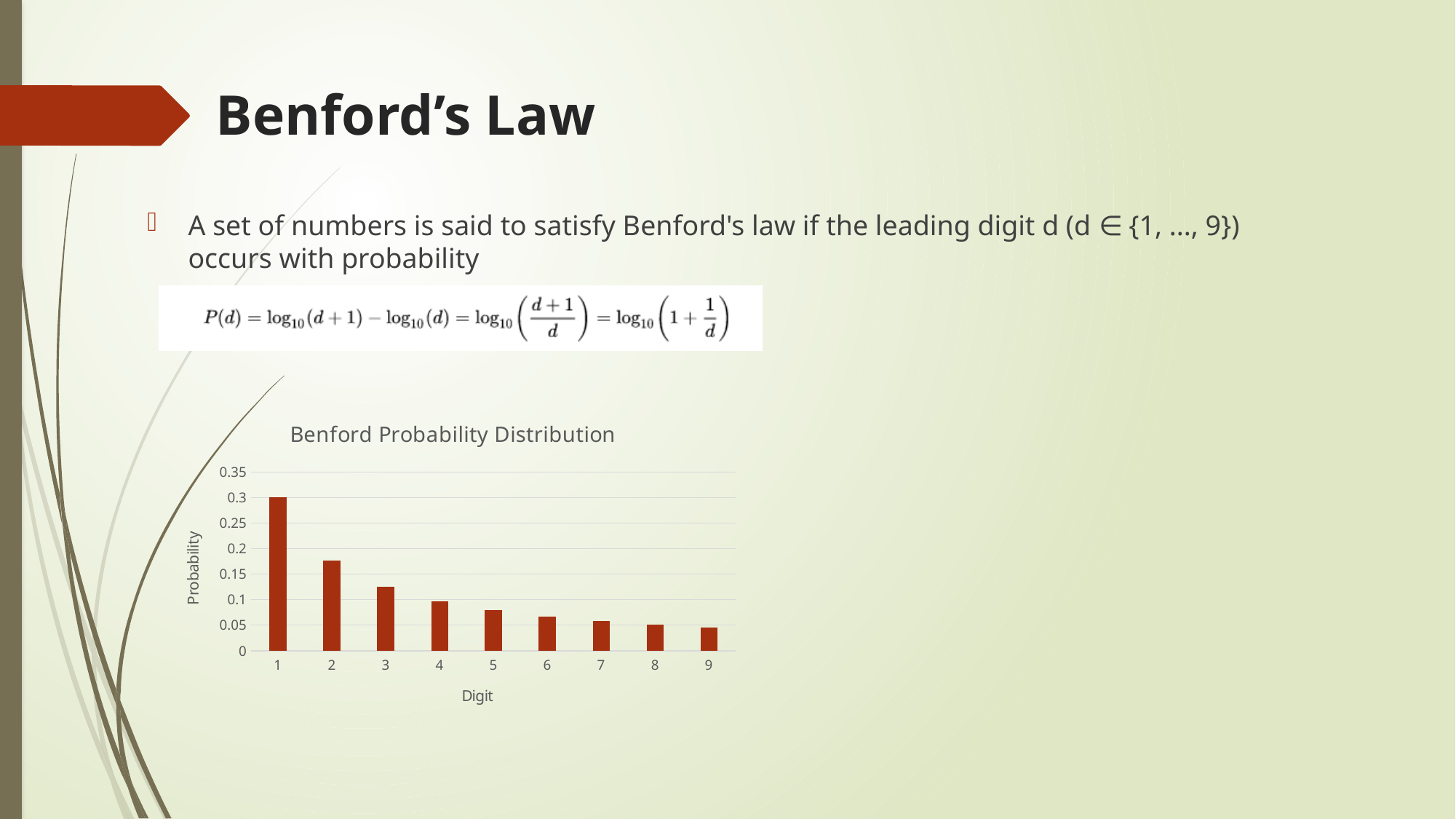
What is the label on the y axis of the chart? Probability What is the title of the chart? Benford Probability Distribution Which digit has the lowest probability in the chart? 9 How many digits (categories) are plotted on the x axis of the chart? 9 Is the probability for digit 2 greater or less than 0.2? less Is the probability for digit 5 greater or less than 0.1? less Is the probability for digit 1 greater or less than 0.25? greater Which digit has the highest probability in the chart? 1 Do the probabilities rise or fall as the digit increases from 1 to 9? fall What kind of chart is shown on the slide? bar chart Which digit has a larger probability, digit 2 or digit 5? 2